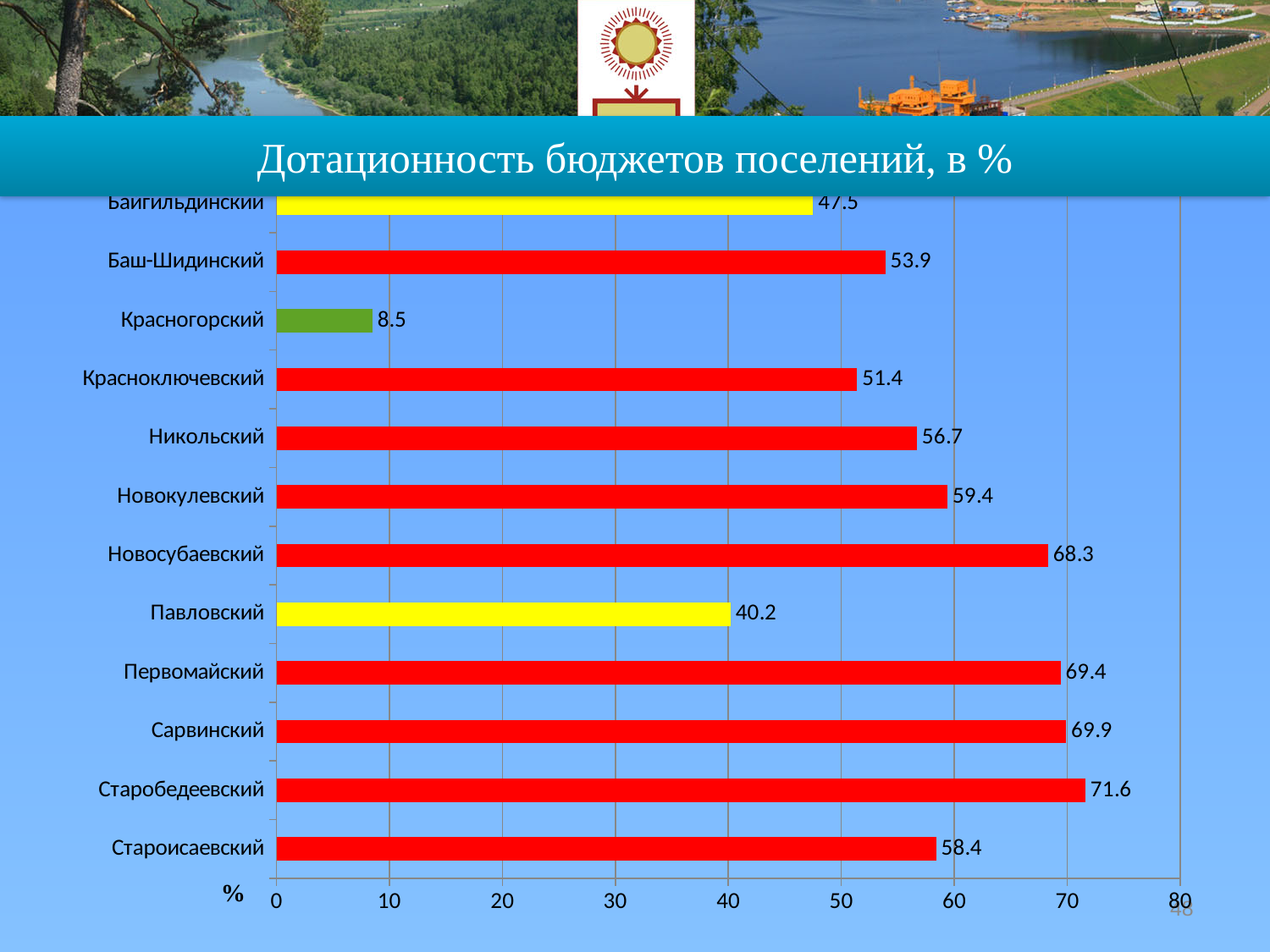
Is the value for Новосубаевский greater or less than 60? greater What kind of chart is shown on the slide? bar chart What is the value for Красногорский? 8.5 What colour is the bar for Красногорский? green What is the difference between the values for Сарвинский and Первомайский? 0.5 What is the value for Старобедеевский? 71.6 What is the value for Павловский? 40.2 Which settlement has the lowest value? Красногорский Which settlement has the highest value? Старобедеевский How many settlements are shown in the chart? 12 Which is larger, the value for Новокулевский or the value for Никольский? Новокулевский What is the title of the chart? Дотационность бюджетов поселений, в %